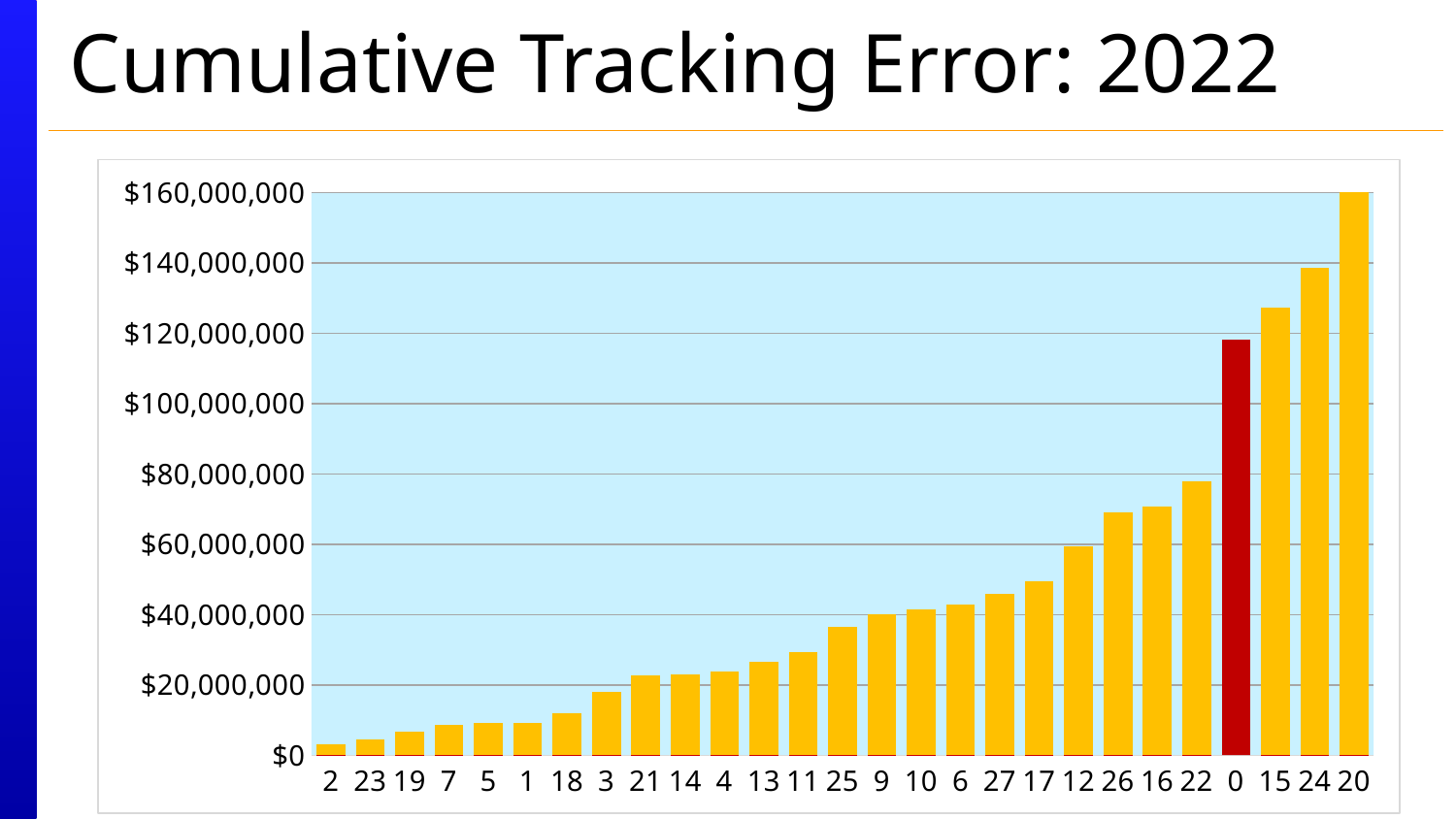
How many bars (categories) are plotted in the chart? 27 Is the value for category 26 greater or less than $60,000,000? greater Which category has the highest cumulative tracking error? 20 Is the value for category 0 greater or less than $120,000,000? less Is the value for category 15 greater or less than $120,000,000? greater Which category's bar is coloured differently (dark red) from the rest? 0 Do the bar values rise or fall moving from left to right along the x axis? rise What kind of chart is shown on the slide? bar chart Which category has the lowest cumulative tracking error? 2 What is the title of the slide? Cumulative Tracking Error: 2022 Which category has the larger value, 15 or 0? 15 Which category has the larger value, 24 or 20? 20